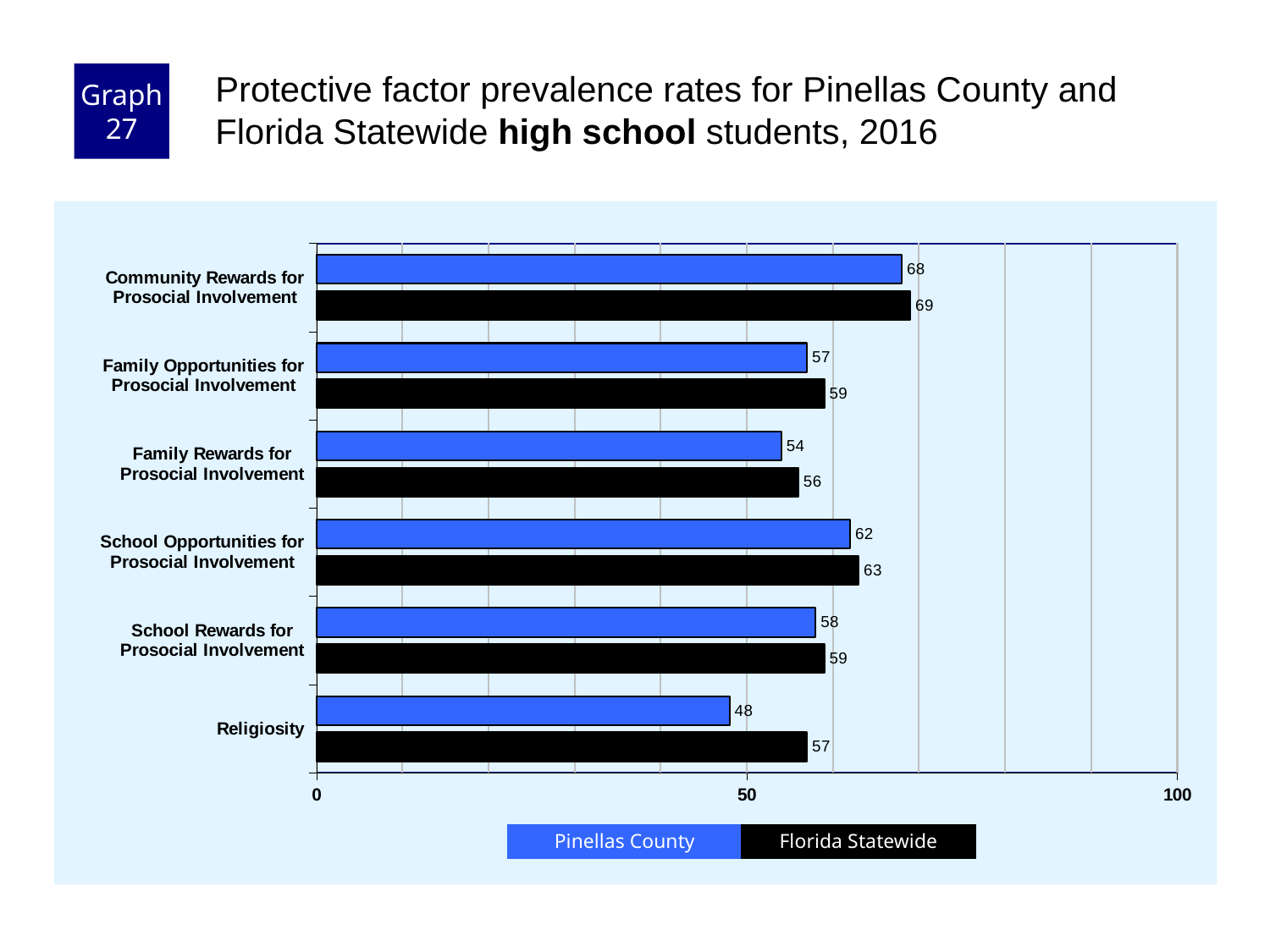
How many series does the legend list? 2 Which category has the highest Pinellas County value? Community Rewards for Prosocial Involvement What is the difference between the Florida Statewide and Pinellas County values for Religiosity? 9 What is the Florida Statewide value for Family Rewards for Prosocial Involvement? 56 Which category has the lowest Pinellas County value? Religiosity What is the Florida Statewide value for Religiosity? 57 Which is larger for School Opportunities for Prosocial Involvement: the Pinellas County value or the Florida Statewide value? Florida Statewide Is the Pinellas County value for Religiosity greater or less than 50? less How many categories are shown on the chart? 6 What is the difference between the Florida Statewide and Pinellas County values for Family Opportunities for Prosocial Involvement? 2 What is the Pinellas County value for Community Rewards for Prosocial Involvement? 68 What kind of chart is shown on the slide? bar chart